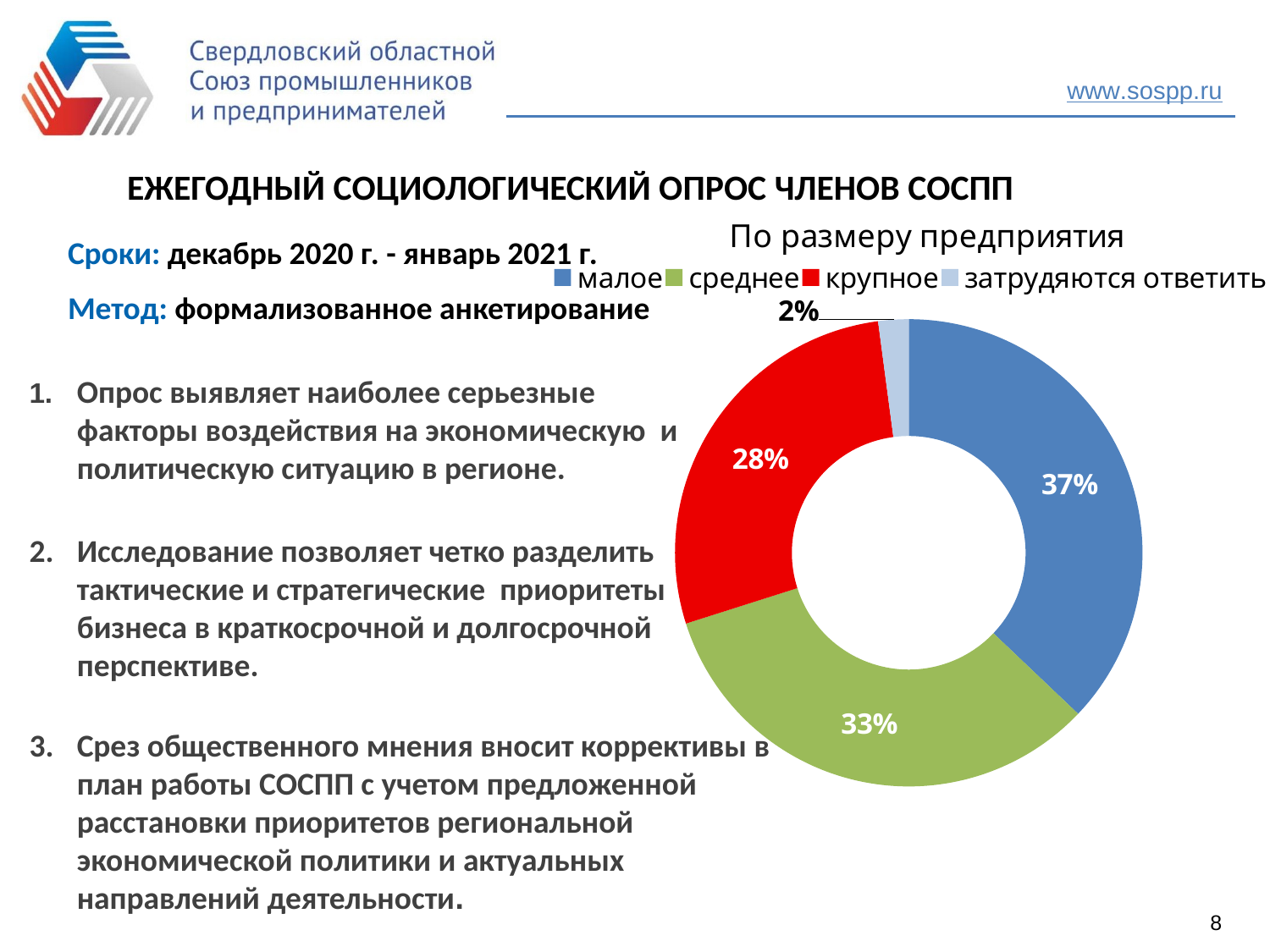
What share of the chart does the 'затрудняются ответить' category hold? 2% Which is larger, the share for 'среднее' or the share for 'крупное'? среднее What is the title of the chart? По размеру предприятия How many categories does the chart show? 4 What colour represents the 'крупное' category in the chart? Red What is the difference in percentage points between the 'малое' and 'крупное' shares? 9 What share of the chart does the 'среднее' category hold? 33% What share of the chart does the 'малое' category hold? 37% Which category has the smallest share in the chart? затрудняются ответить What share of the chart does the 'крупное' category hold? 28% Which category has the largest share in the chart? малое What kind of chart is shown on the slide? Doughnut (pie) chart